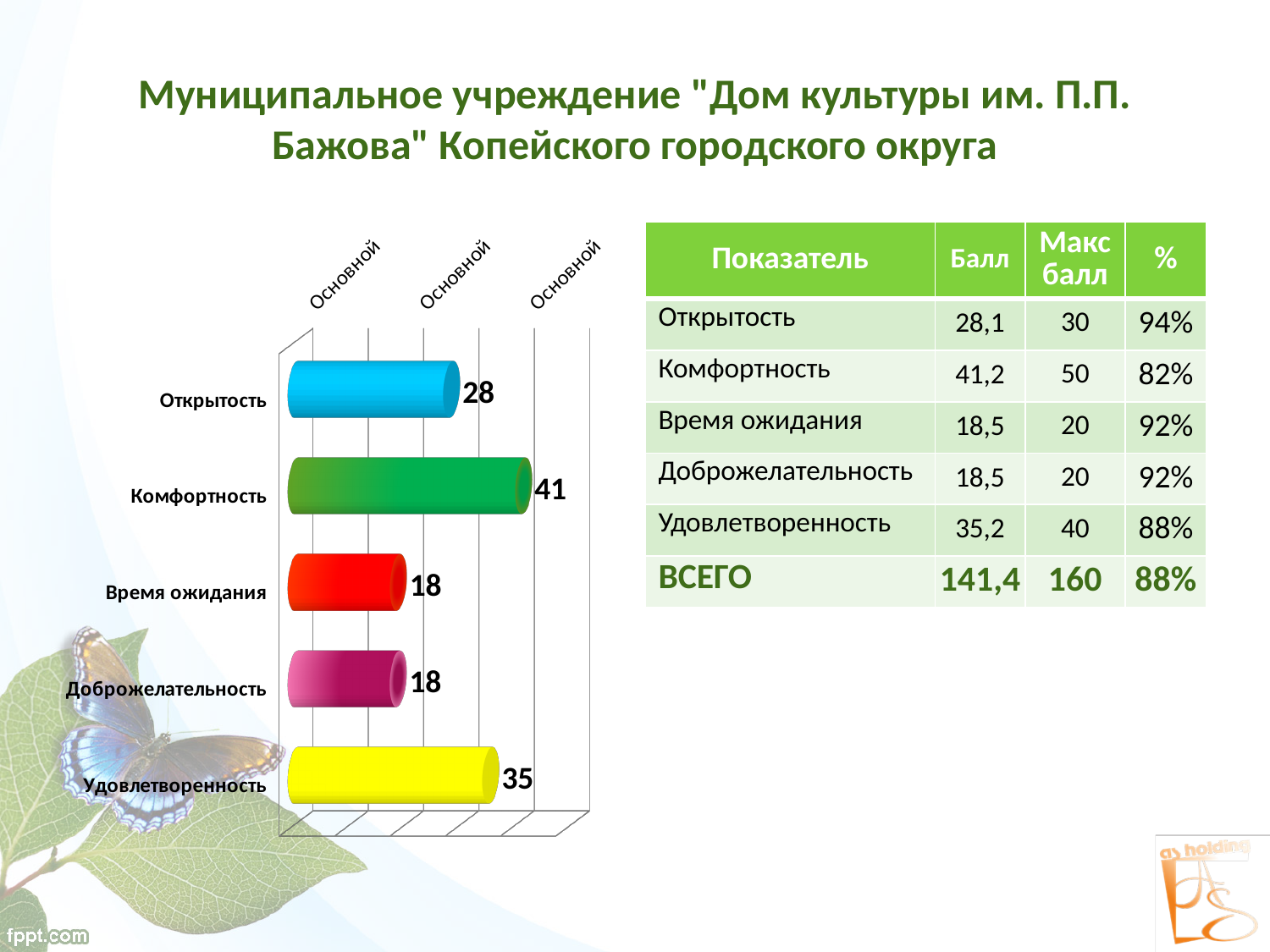
What is the value shown for Удовлетворенность on the chart? 35 What is the value shown for Доброжелательность on the chart? 18 What is the lowest value shown on the chart? 18 What is the value shown for Открытость on the chart? 28 What is the value shown for Комфортность on the chart? 41 Which category has the highest value on the chart? Комфортность How many categories are shown on the chart? 5 What is the value shown for Время ожидания on the chart? 18 What type of chart is shown on the slide? Bar chart What is the difference between the values for Комфортность and Открытость on the chart? 13 What is the difference between the values for Удовлетворенность and Время ожидания on the chart? 17 Which is larger on the chart, the value for Удовлетворенность or the value for Открытость? Удовлетворенность